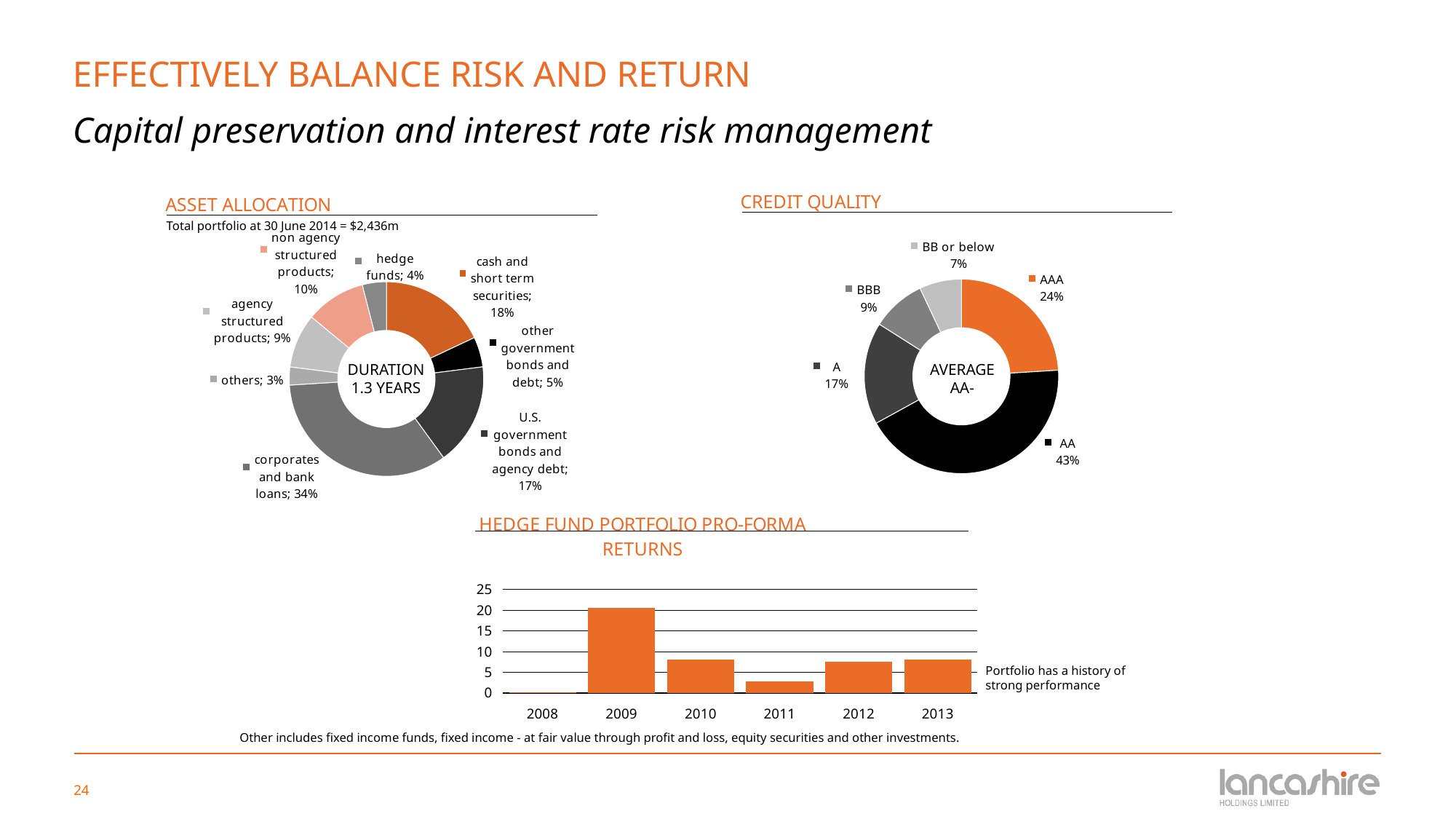
What kind of chart is the Hedge Fund Portfolio Pro-Forma Returns chart? bar chart In the Credit Quality chart, what share of the portfolio is rated AA? 43% In the Asset Allocation chart, what is the difference between the shares of non agency structured products and agency structured products? 1% In the Asset Allocation chart, what share of the portfolio is corporates and bank loans? 34% In the Credit Quality chart, which rating has the smallest share? BB or below In the Credit Quality chart, which is larger, the share rated AAA or the share rated A? AAA In the Asset Allocation chart, which category has the smallest share? others In the Asset Allocation chart, which category has the largest share? corporates and bank loans In the Hedge Fund Portfolio Pro-Forma Returns chart, is the value for 2011 greater or less than 5? less In the Asset Allocation chart, what share is cash and short term securities? 18% In the Hedge Fund Portfolio Pro-Forma Returns chart, which year has the highest bar? 2009 In the Credit Quality chart, how many rating categories are shown? 5